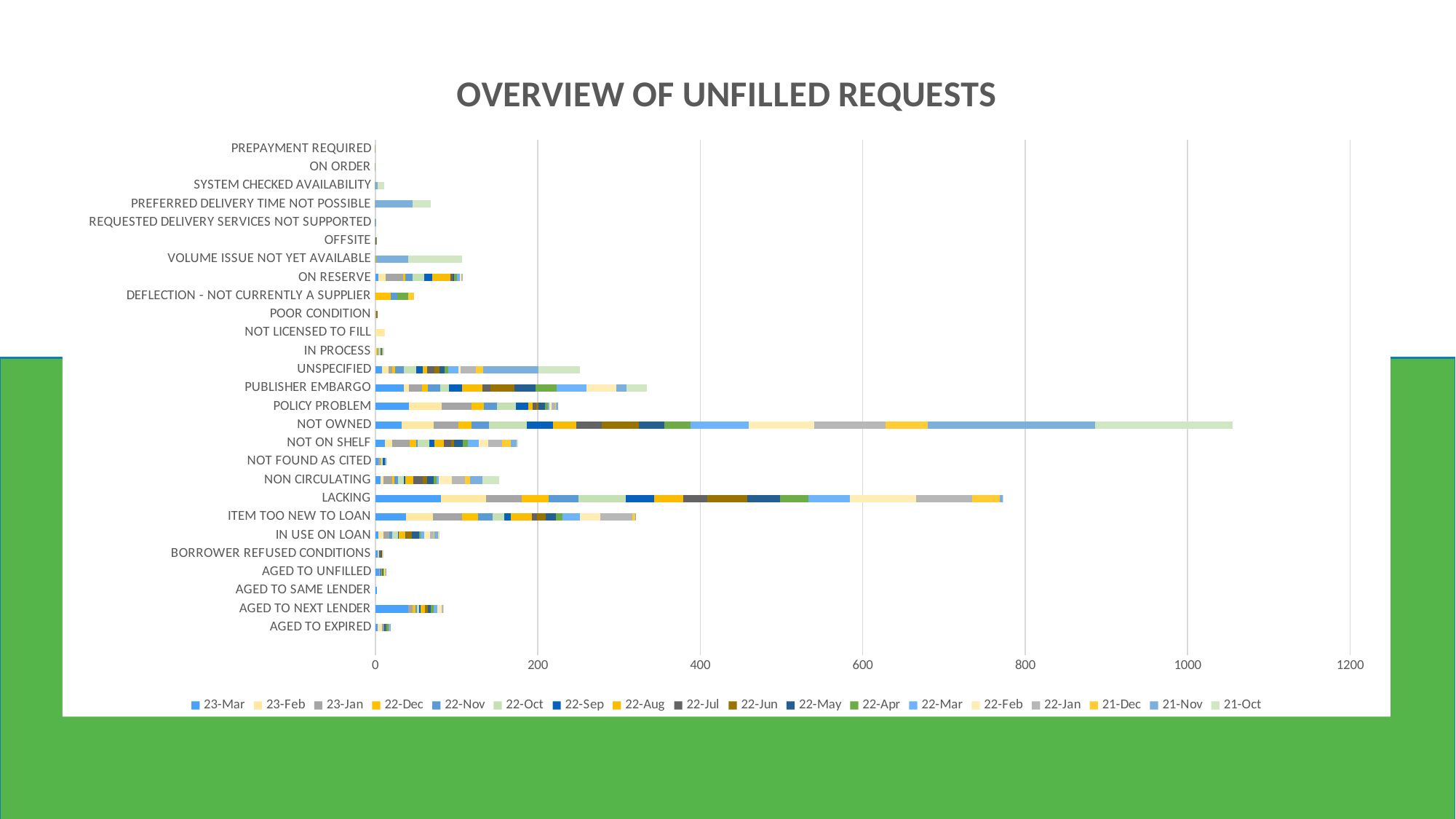
Is the total bar for ITEM TOO NEW TO LOAN greater or less than 200? greater Is the total bar for NOT OWNED greater or less than 1000? greater Is the total bar for LACKING greater or less than 800? less Which has the longer total bar, LACKING or ITEM TOO NEW TO LOAN? LACKING How many categories are shown on the vertical axis of the chart? 27 What kind of chart is shown on the slide? Stacked bar chart How many series does the legend list? 18 What is the title of the chart? OVERVIEW OF UNFILLED REQUESTS Which has the longer total bar, PUBLISHER EMBARGO or NOT ON SHELF? PUBLISHER EMBARGO Which category has the longest total bar? NOT OWNED